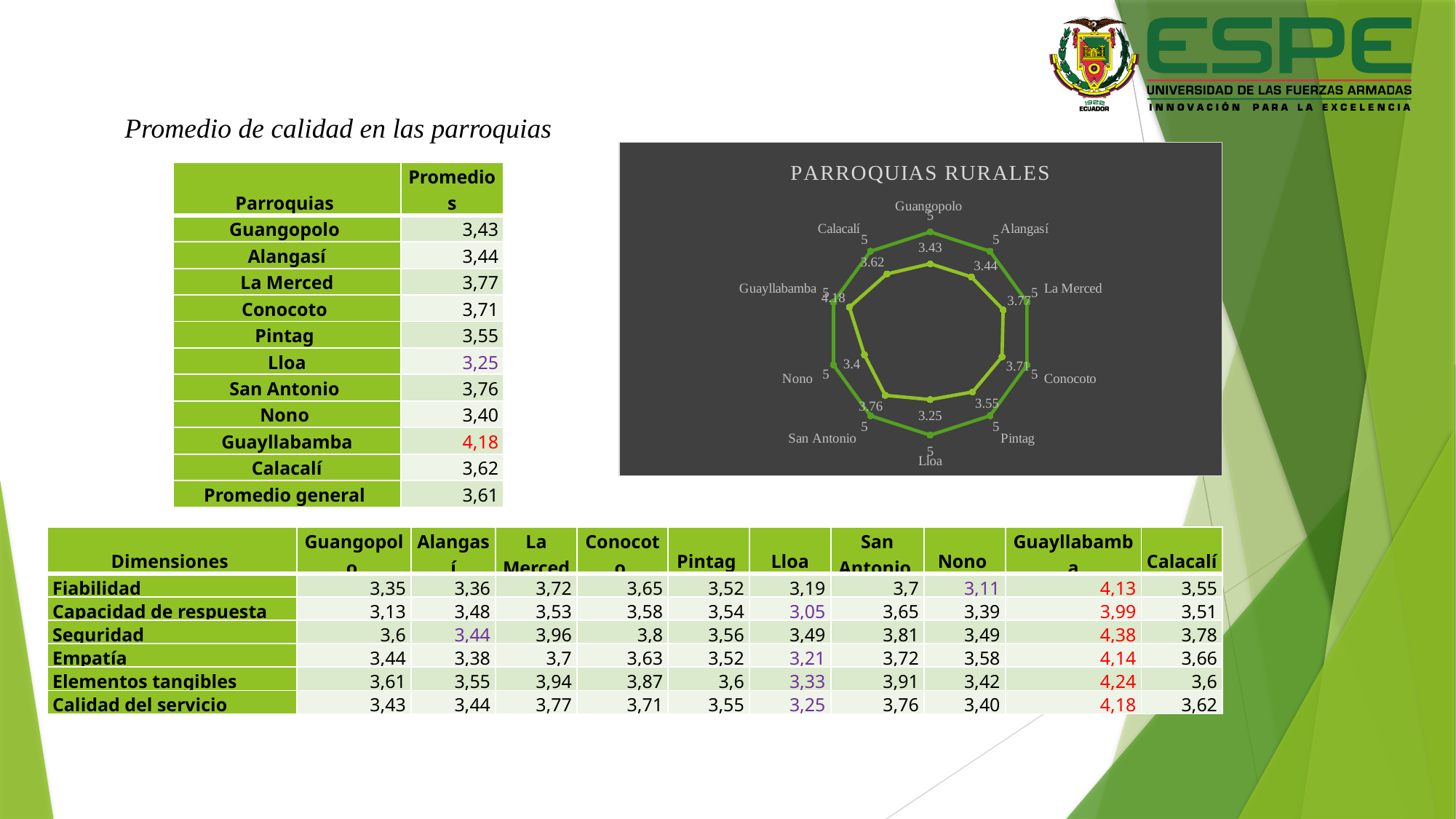
What is the value plotted for Guayllabamba on the radar chart? 4.18 Which parroquia has the highest value on the radar chart? Guayllabamba Which has a larger value on the radar chart, Conocoto or Pintag? Conocoto What is the difference between the values for Guayllabamba and Lloa on the radar chart? 0.93 What is the value plotted for La Merced on the radar chart? 3.77 How many parroquias (categories) are plotted on the radar chart? 10 Which parroquia has the lowest value on the radar chart? Lloa What is the title of the chart? PARROQUIAS RURALES What kind of chart is shown on the slide? Radar chart What is the value plotted for Nono on the radar chart? 3.4 What is the value plotted for Lloa on the radar chart? 3.25 What is the difference between the values for Calacalí and Guangopolo on the radar chart? 0.19